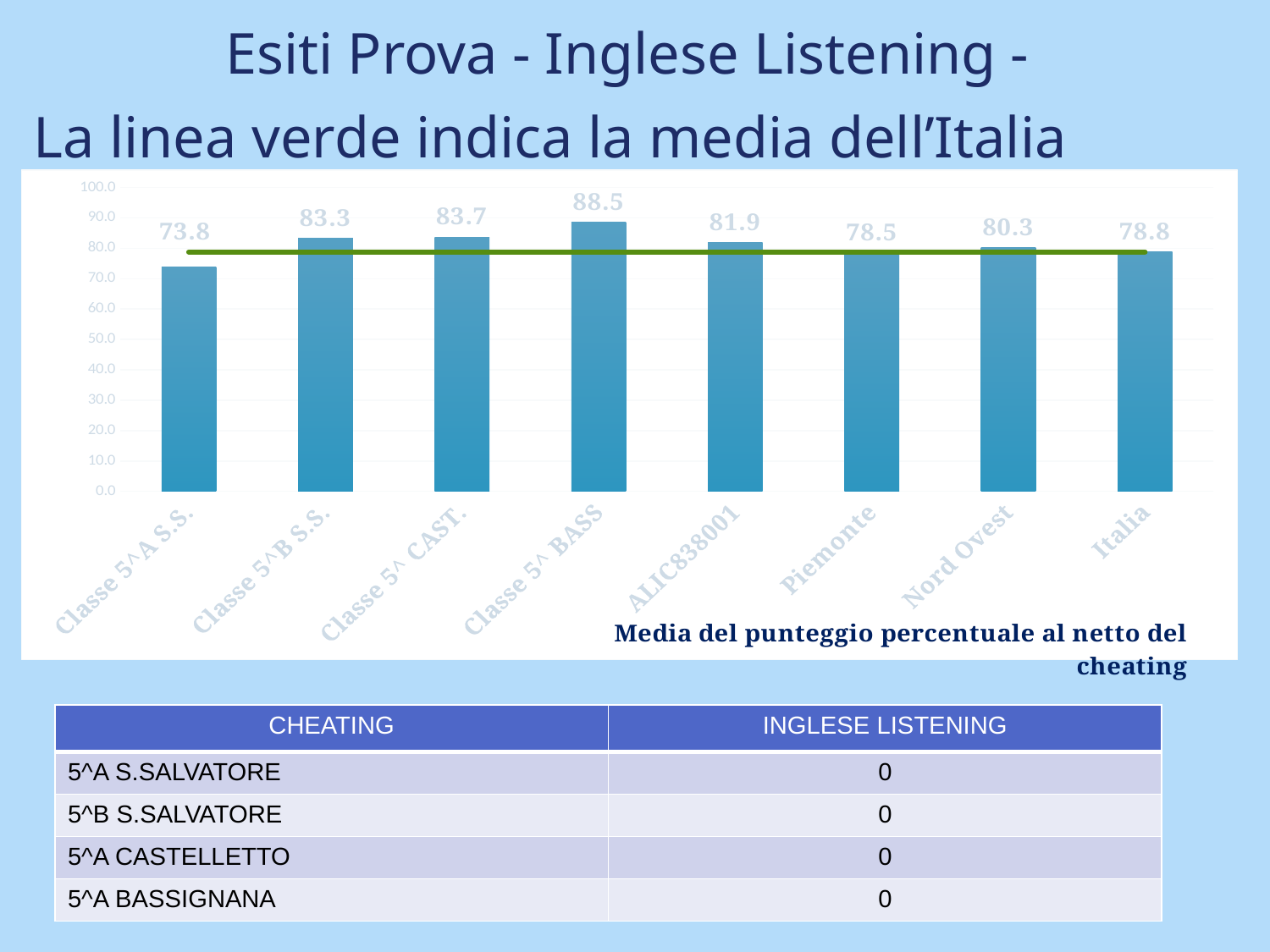
What is the value for ALIC838001? 81.9 What is the difference between the values for Classe 5^ BASS and Classe 5^A S.S.? 14.7 Which category has the highest value? Classe 5^ BASS Is the value for Classe 5^A S.S. greater or less than 80.0? less What is the value for Italia? 78.8 According to the slide title, what does the green line indicate? la media dell'Italia What is the value for Piemonte? 78.5 What is the value for Classe 5^ BASS? 88.5 Which category has the lowest value? Classe 5^A S.S. What kind of chart is shown on the slide? combination bar and line chart How many categories are shown on the x axis? 8 Which is larger, the value for Nord Ovest or the value for Piemonte? Nord Ovest